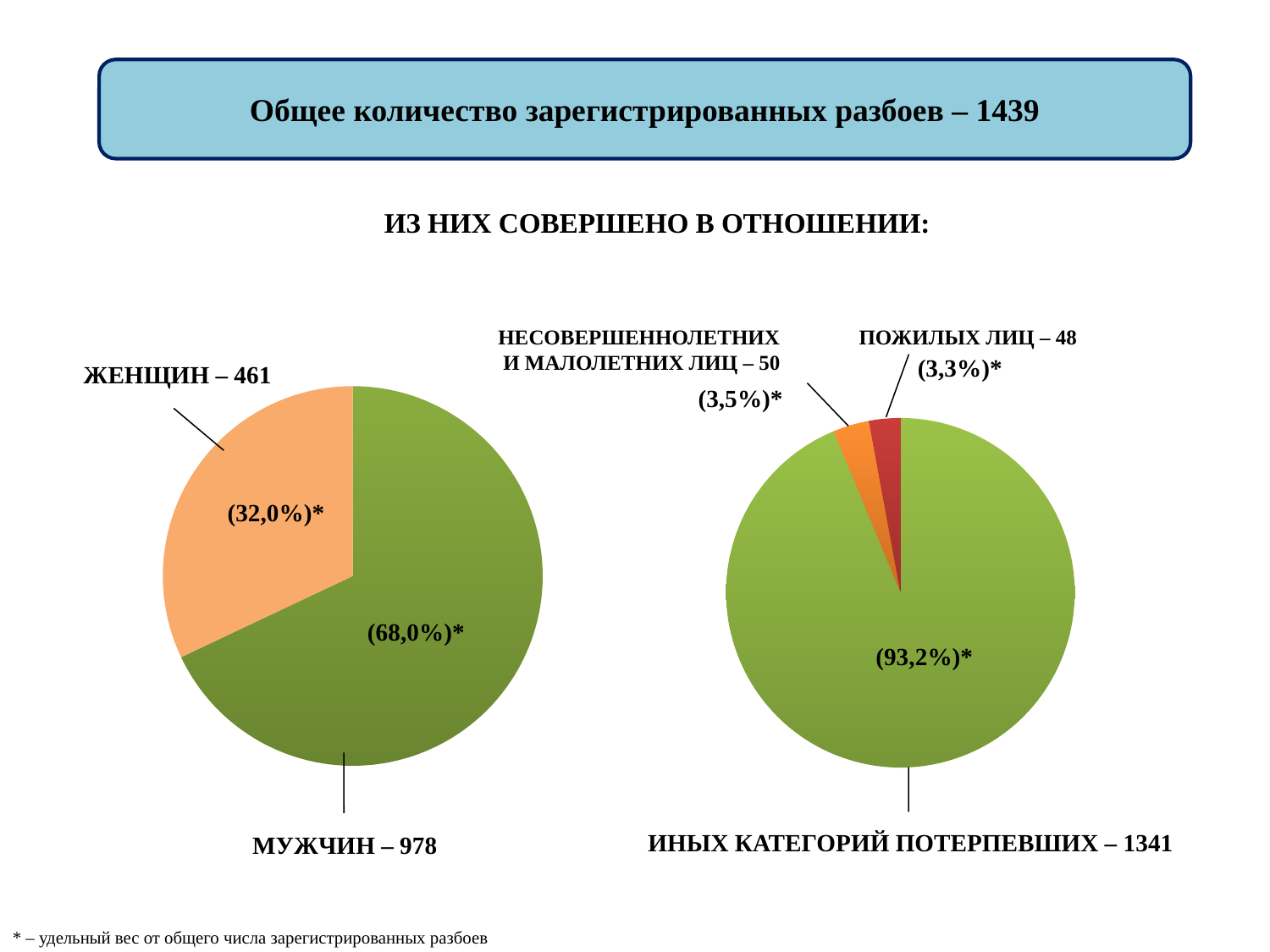
In the right pie chart, what is the value for ПОЖИЛЫХ ЛИЦ? 48 In the right pie chart, what is the difference between the values for НЕСОВЕРШЕННОЛЕТНИХ И МАЛОЛЕТНИХ ЛИЦ and ПОЖИЛЫХ ЛИЦ? 2 In the left pie chart, what share of the pie does the МУЖЧИН slice represent? 68,0% What kind of chart is used on the left side of the slide? pie chart In the left pie chart, what is the value for ЖЕНЩИН? 461 In the left pie chart, what is the total of the two slices? 1439 In the right pie chart, which category has the largest value? ИНЫХ КАТЕГОРИЙ ПОТЕРПЕВШИХ In the left pie chart, what is the value for МУЖЧИН? 978 In the right pie chart, how many slices are there? 3 In the left pie chart, what is the difference between the values for МУЖЧИН and ЖЕНЩИН? 517 In the right pie chart, what share of the pie does the ИНЫХ КАТЕГОРИЙ ПОТЕРПЕВШИХ slice represent? 93,2% In the right pie chart, what is the value for НЕСОВЕРШЕННОЛЕТНИХ И МАЛОЛЕТНИХ ЛИЦ? 50